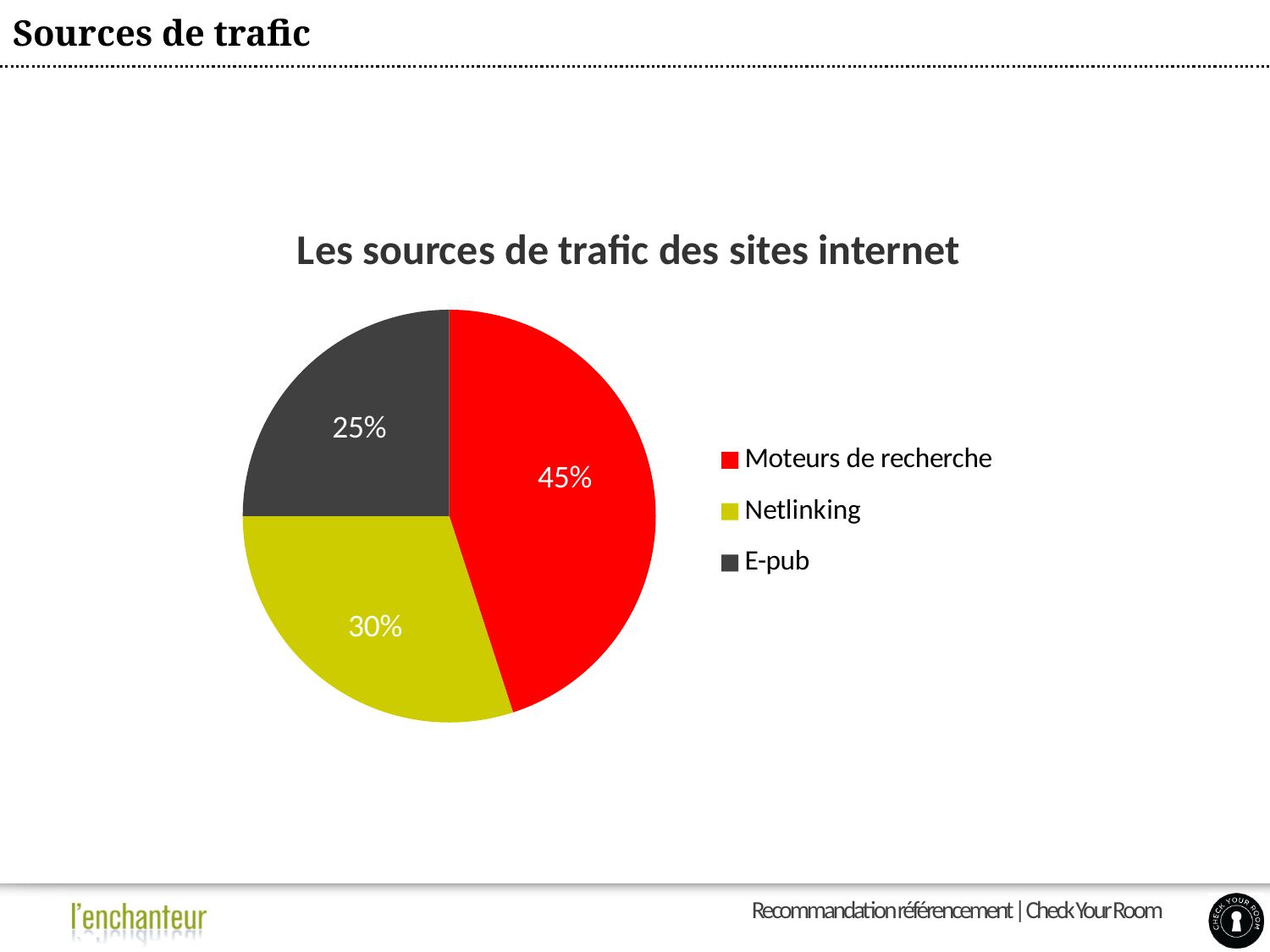
What kind of chart is shown on the slide? Pie chart Which is larger, the share for Netlinking or the share for E-pub? Netlinking What share of traffic comes from Moteurs de recherche? 45% What share of traffic comes from Netlinking? 30% Which traffic source has the largest share? Moteurs de recherche How many slices does the pie chart have? 3 What is the difference in percentage points between Moteurs de recherche and E-pub? 20 What is the title of the chart? Les sources de trafic des sites internet What colour is the slice for Netlinking? Yellow-green What share of traffic comes from E-pub? 25% What is the difference in percentage points between Netlinking and E-pub? 5 Which traffic source has the smallest share? E-pub